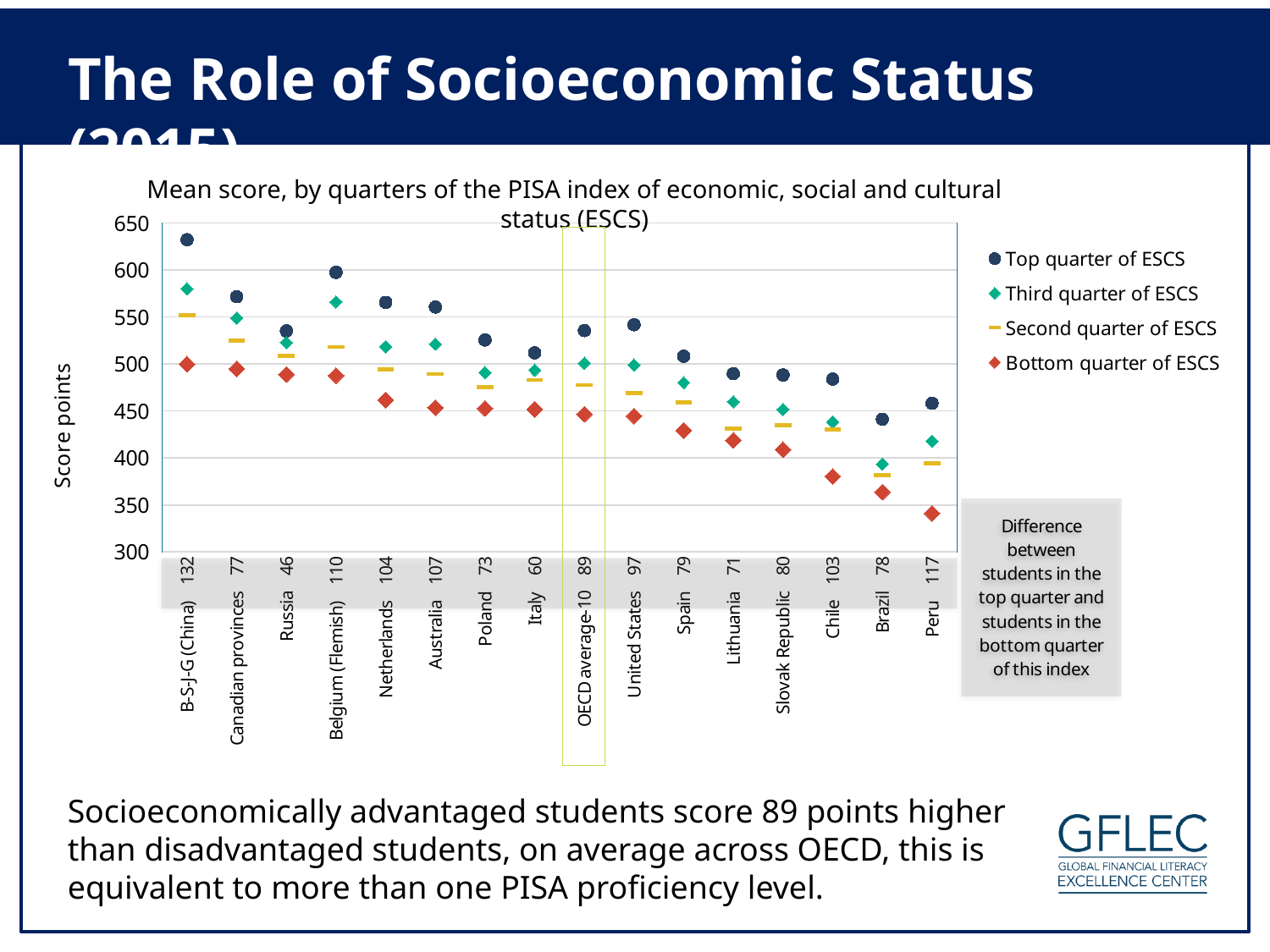
What is the difference between top-quarter and bottom-quarter students shown for B-S-J-G (China)? 132 What is the difference between top-quarter and bottom-quarter students shown for Peru? 117 How many series does the legend list? 4 Which country has the largest printed difference between top-quarter and bottom-quarter students? B-S-J-G (China) How many countries or groups are shown along the x axis? 16 How much larger is the printed top-bottom difference for B-S-J-G (China) than for Russia? 86 Is the Bottom quarter of ESCS score for Chile greater or less than 400? less What is the difference between top-quarter and bottom-quarter students shown for the OECD average-10? 89 Which has a higher Top quarter of ESCS score, B-S-J-G (China) or Peru? B-S-J-G (China) Is the Bottom quarter of ESCS score for Peru greater or less than 350? less Which country has the smallest printed difference between top-quarter and bottom-quarter students? Russia Is the Top quarter of ESCS score for B-S-J-G (China) greater or less than 600? greater